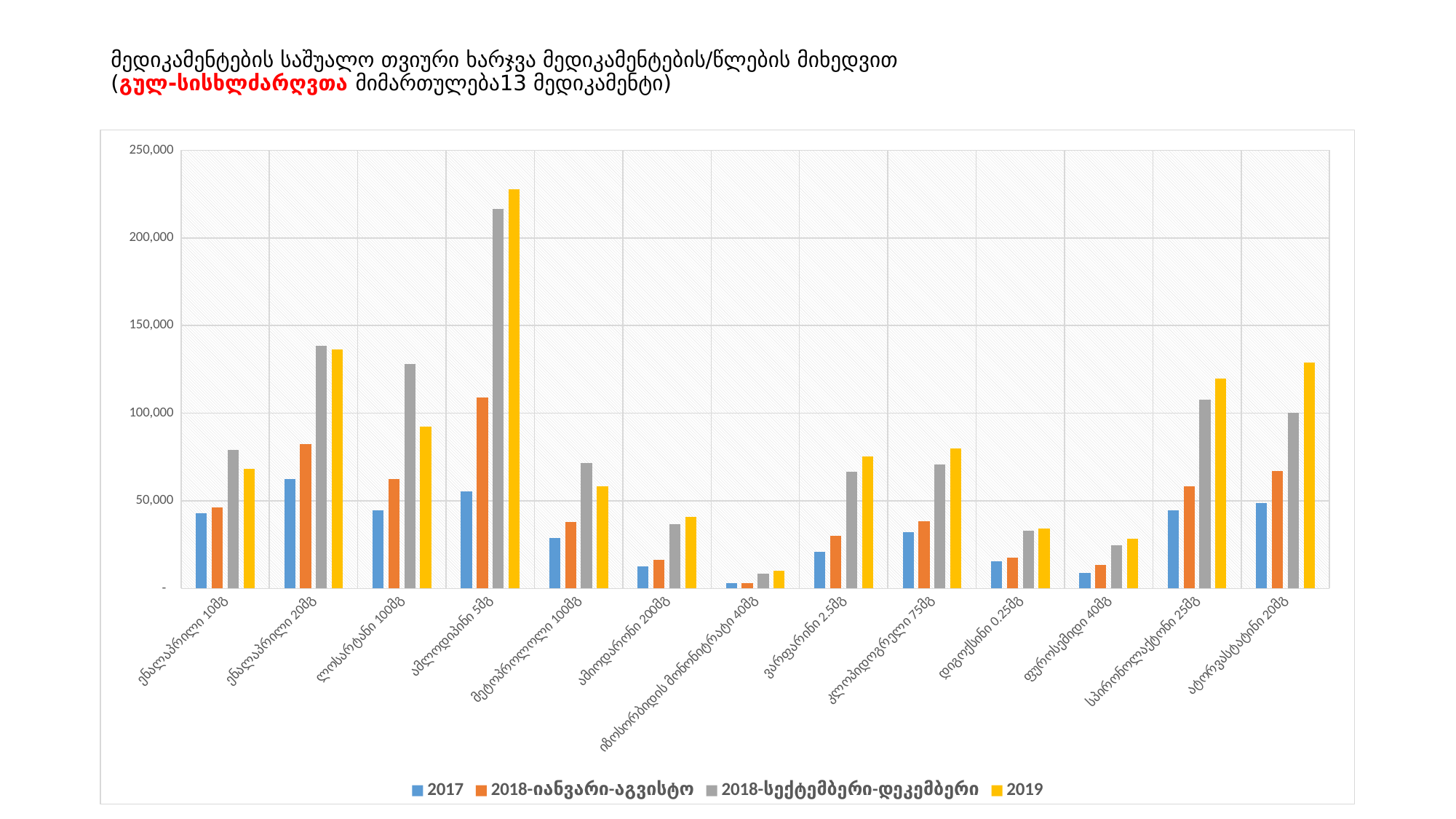
Which series is shown in yellow in the legend? 2019 Is the 2019 value for ამლოდიპინი 5მგ greater or less than 200,000? greater Is the 2018-სექტემბერი-დეკემბერი value for ენალაპრილი 20მგ greater or less than 100,000? greater How many series does the legend list? 4 For the 2019 series, which is larger: ამლოდიპინი 5მგ or ენალაპრილი 20მგ? ამლოდიპინი 5მგ Which medication has the lowest value for the 2019 series? იზოსორბიდის მონონიტრატი 40მგ How many medication categories are shown on the x axis? 13 Which medication has the lowest value for the 2017 series? იზოსორბიდის მონონიტრატი 40მგ Which medication has the highest value for the 2019 series? ამლოდიპინი 5მგ What kind of chart is shown on the slide? bar chart Is the 2019 value for ლოსარტანი 100მგ greater or less than 100,000? less